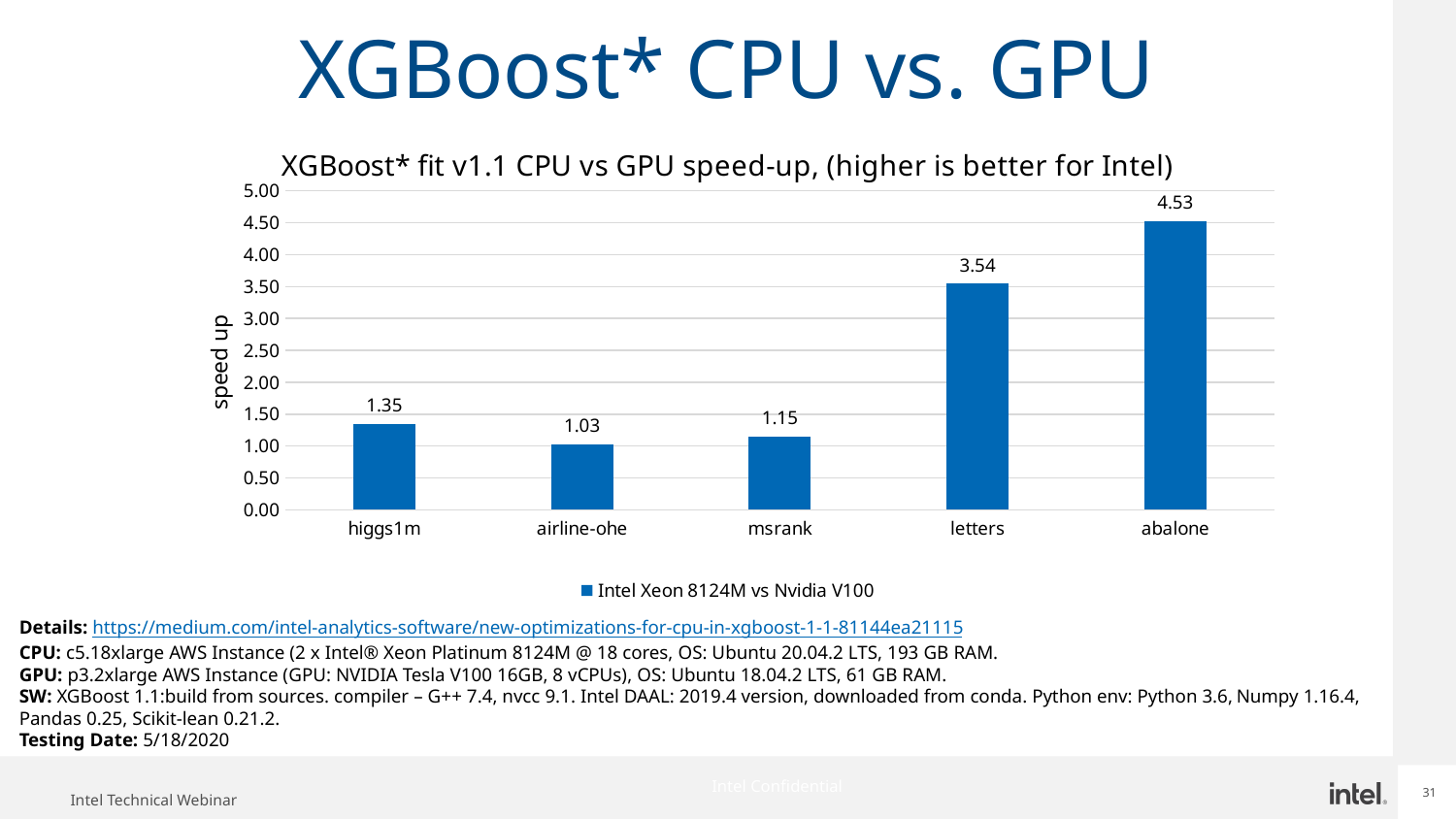
What is the speed-up value for higgs1m? 1.35 What is the difference between the speed-up for abalone and the speed-up for letters? 0.99 What is the speed-up value for msrank? 1.15 How many series does the legend list? 1 Is the speed-up for letters greater or less than 3.00? greater What is the legend entry for the series in the chart? Intel Xeon 8124M vs Nvidia V100 Which has a larger speed-up, letters or msrank? letters What kind of chart is shown on the slide? bar chart Which dataset has the highest speed-up? abalone Which dataset has the lowest speed-up? airline-ohe How many datasets are shown on the x axis? 5 What is the speed-up value for abalone? 4.53